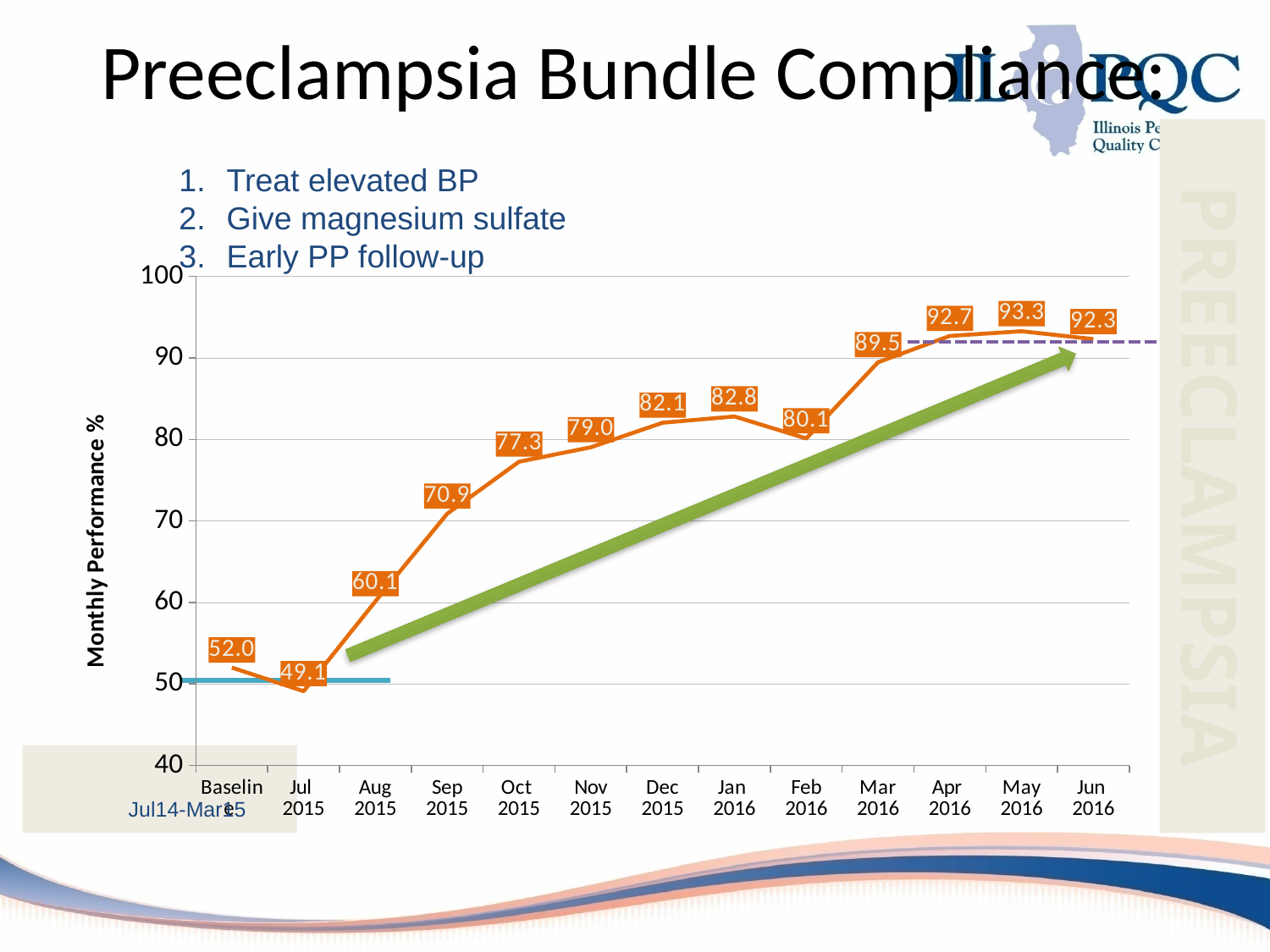
What is the label of the vertical axis? Monthly Performance % What is the monthly performance value for Aug 2015? 60.1 Which month has the lowest monthly performance value? Jul 2015 Which month has the highest monthly performance value? May 2016 Which is larger, the value for Jan 2016 or the value for Feb 2016? Jan 2016 What is the monthly performance value for the Baseline period? 52.0 What is the difference between the values for Jun 2016 and Jul 2015? 43.2 Does the monthly performance generally rise or fall from Jul 2015 to Jun 2016? rise How many data points are plotted on the chart? 13 What type of chart is shown on the slide? line chart What is the difference between the values for Sep 2015 and Aug 2015? 10.8 What is the monthly performance value for Jun 2016? 92.3